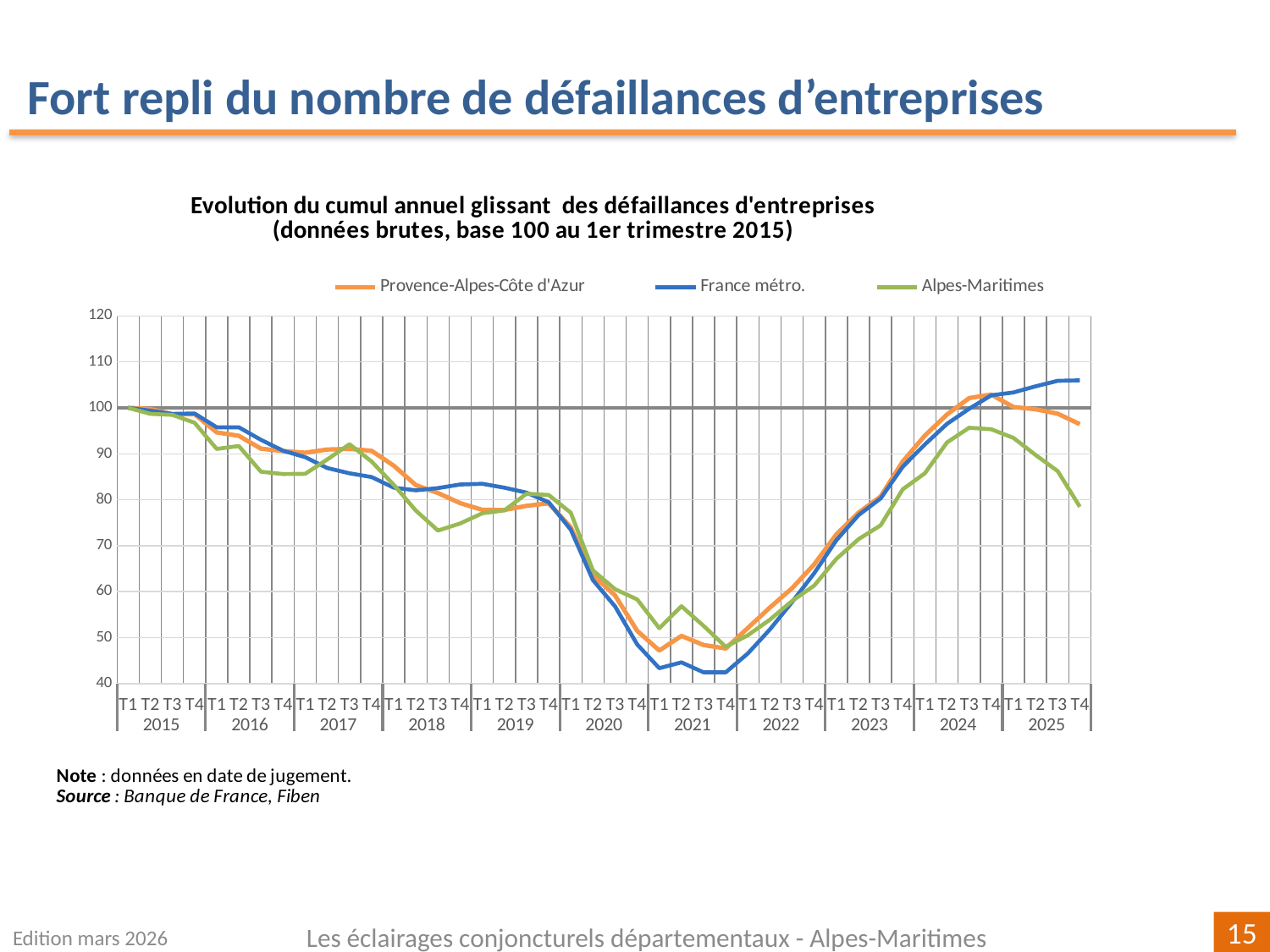
What is the base value of the index at the 1st quarter of 2015, according to the chart title? 100 Is the value for France métro. at T4 2025 greater or less than 100? greater How many series does the legend list? 3 Which series is drawn in green? Alpes-Maritimes Does the Alpes-Maritimes series rise or fall between T1 2025 and T4 2025? fall At T2 2021, which series is higher: Alpes-Maritimes or France métro.? Alpes-Maritimes At T4 2025, which series is higher: France métro. or Alpes-Maritimes? France métro. Is the value for France métro. at T4 2021 greater or less than 50? less Is the value for Alpes-Maritimes at T4 2025 greater or less than 90? less What kind of chart is shown on the slide? line chart Which series reaches the lowest point on the chart? France métro.